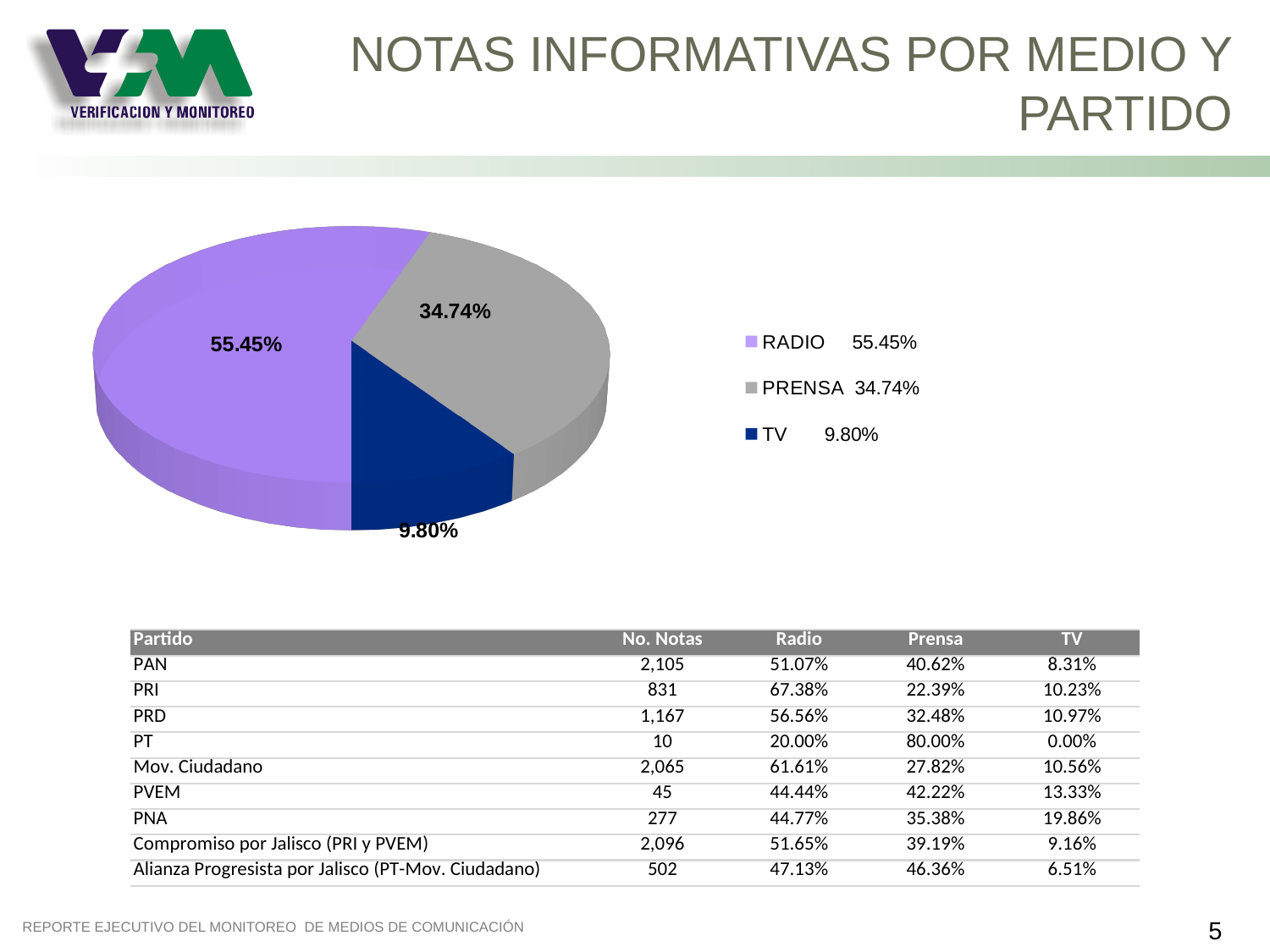
Which medium has the smallest slice of the pie? TV What is the difference in percentage points between the PRENSA and TV slices? 24.94 What colour is the RADIO slice in the pie chart? purple Which medium has the largest slice of the pie? RADIO What share of the pie does RADIO have? 55.45% How many entries does the legend of the pie chart list? 3 What kind of chart is shown on the slide? pie chart What share of the pie does PRENSA have? 34.74% What is the difference in percentage points between the RADIO and PRENSA slices? 20.71 What share of the pie does TV have? 9.80% Which slice is larger, PRENSA or TV? PRENSA How many slices does the pie chart have? 3